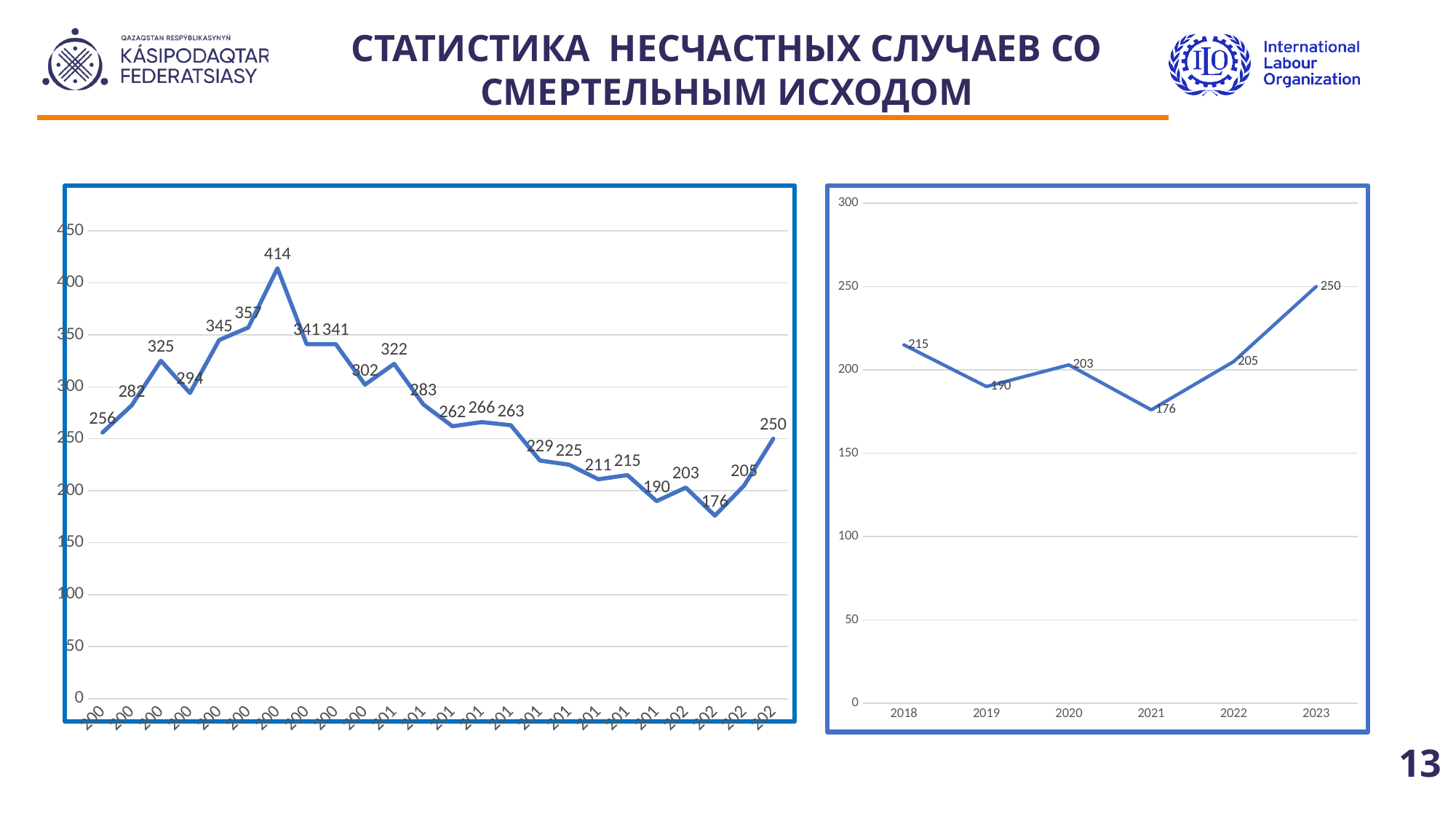
On the left chart, what is the lowest value plotted? 176 On the right chart, how many years are plotted? 6 On the right chart, what is the value for 2021? 176 On the right chart, which is larger, the value for 2018 or the value for 2020? 2018 On the right chart, what is the value for 2019? 190 On the right chart, what is the difference between the values for 2023 and 2022? 45 On the right chart, do the values rise or fall from 2021 to 2023? rise On the right chart, what is the value for 2023? 250 On the right chart, which year has the lowest value? 2021 What kind of chart is the left chart? line chart On the left chart, what is the highest value plotted? 414 On the right chart, which year has the highest value? 2023